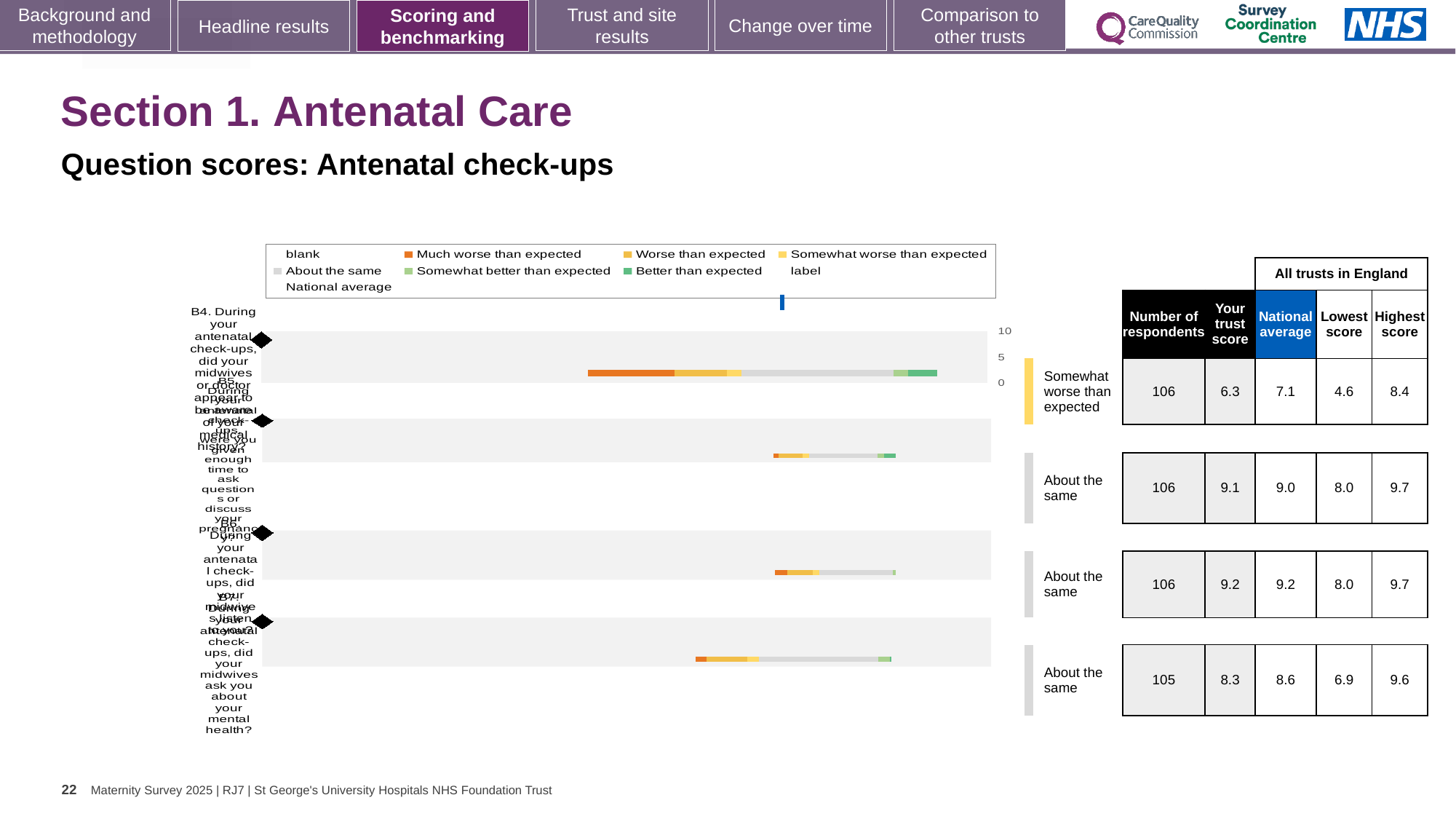
What is the National average for the first (top) row, question B4? 7.1 What is the Lowest score among all trusts in England for the last row (B7)? 6.9 What kind of chart is shown on the slide? bar chart For the last row (B7), which is larger: the trust score or the National average? National average How many respondents are listed for the last (bottom) row, question B7? 105 What benchmark category label is shown next to the first row (B4)? Somewhat worse than expected For the first row (B4), what is the difference between the National average and the trust score? 0.8 Which row has the lowest 'Your trust score'? the first row (B4), 6.3 Which row has the highest 'Your trust score'? the third row (B6), 9.2 What is the 'Your trust score' for the first (top) row, question B4? 6.3 What is the Highest score among all trusts in England for the second row (B5)? 9.7 How many question rows are shown in the chart and table? 4